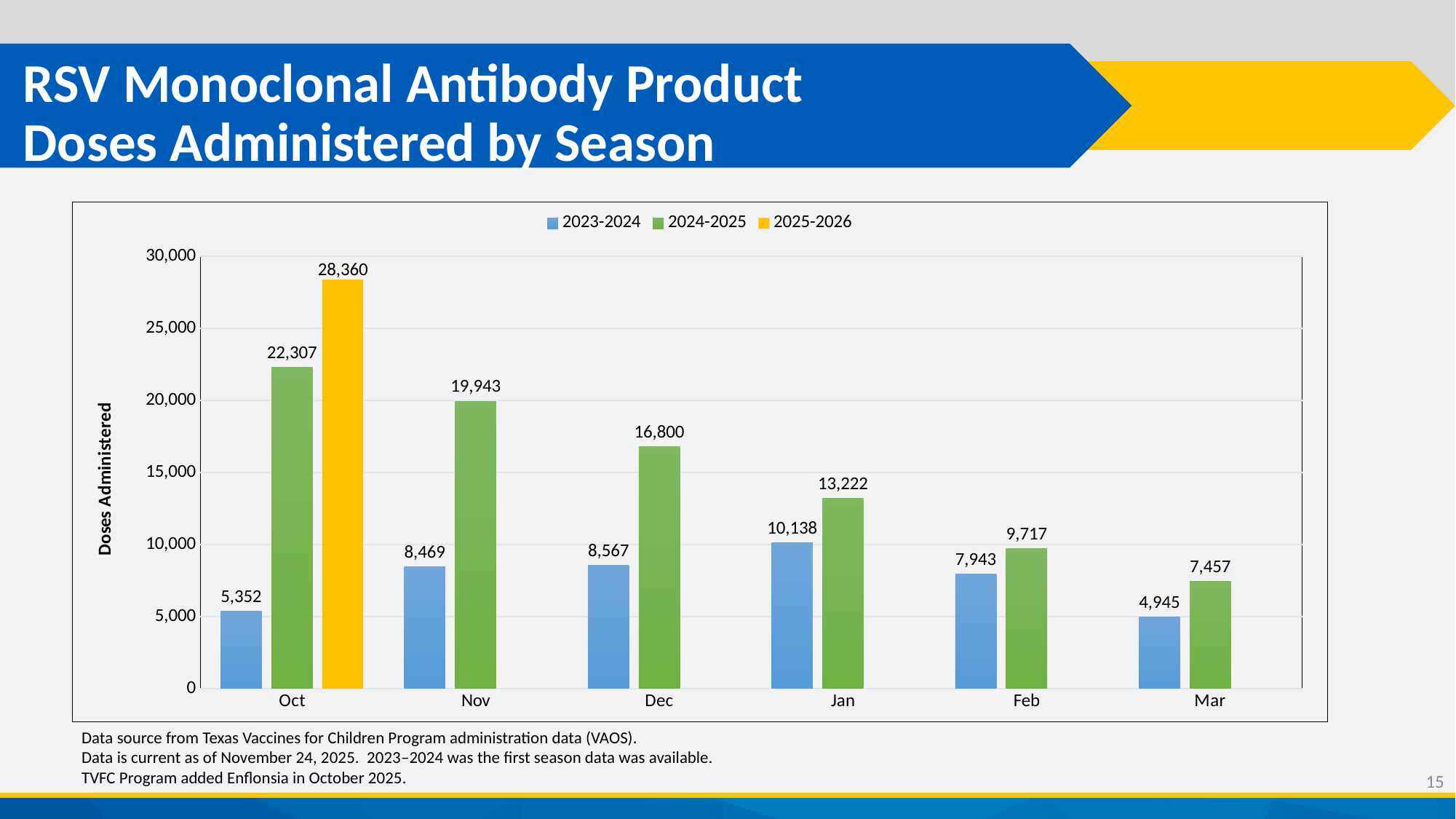
What kind of chart is shown on the slide? bar chart How many series does the legend list? 3 How many doses were administered in October in the 2025-2026 season? 28,360 Do the 2024-2025 values rise or fall from October to March? fall How many doses were administered in December in the 2024-2025 season? 16,800 Which is larger in February: the 2023-2024 value or the 2024-2025 value? 2024-2025 What is the difference between the 2024-2025 and 2023-2024 values in October? 16,955 Which month has the highest value for the 2023-2024 season? Jan How many months are shown on the x axis? 6 Is the value for the 2024-2025 season in January greater or less than 15,000? less What is the value for the 2023-2024 season in November? 8,469 Which month has the lowest value for the 2024-2025 season? Mar